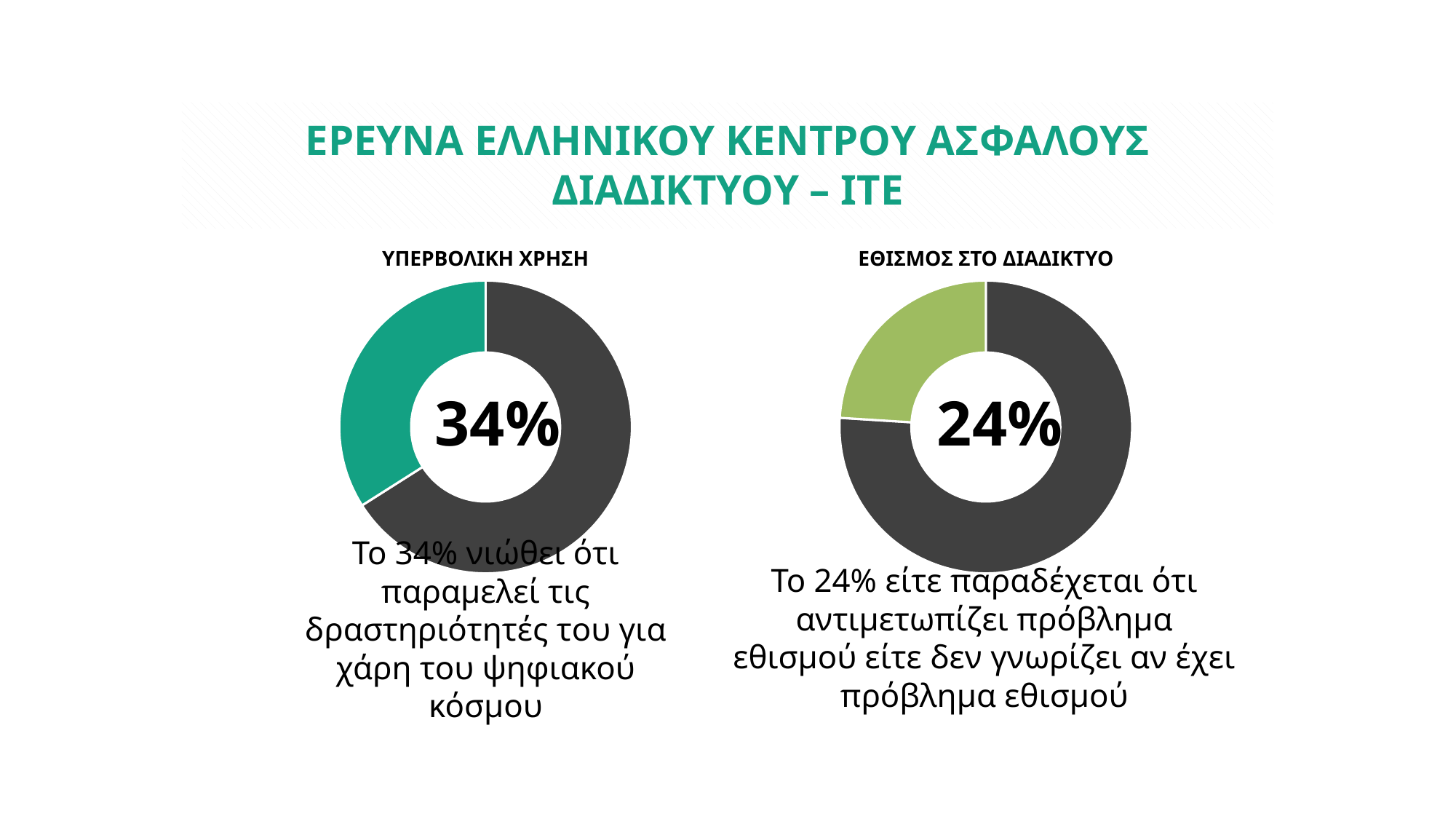
What kind of chart is the "ΕΘΙΣΜΟΣ ΣΤΟ ΔΙΑΔΙΚΤΥΟ" chart? Doughnut (pie) chart Which chart shows the larger highlighted percentage, "ΥΠΕΡΒΟΛΙΚΗ ΧΡΗΣΗ" or "ΕΘΙΣΜΟΣ ΣΤΟ ΔΙΑΔΙΚΤΥΟ"? ΥΠΕΡΒΟΛΙΚΗ ΧΡΗΣΗ In the "ΥΠΕΡΒΟΛΙΚΗ ΧΡΗΣΗ" chart, what share of the ring does the teal (green) slice represent? 34% How many slices does the "ΥΠΕΡΒΟΛΙΚΗ ΧΡΗΣΗ" doughnut chart have? 2 In the "ΥΠΕΡΒΟΛΙΚΗ ΧΡΗΣΗ" chart, what percentage is printed in the centre? 34% In the "ΕΘΙΣΜΟΣ ΣΤΟ ΔΙΑΔΙΚΤΥΟ" chart, what share of the ring does the light green slice represent? 24% What is the title of the chart on the left of the slide? ΥΠΕΡΒΟΛΙΚΗ ΧΡΗΣΗ What is the title of the chart on the right of the slide? ΕΘΙΣΜΟΣ ΣΤΟ ΔΙΑΔΙΚΤΥΟ In the "ΕΘΙΣΜΟΣ ΣΤΟ ΔΙΑΔΙΚΤΥΟ" chart, what percentage is printed in the centre? 24% How many slices does the "ΕΘΙΣΜΟΣ ΣΤΟ ΔΙΑΔΙΚΤΥΟ" doughnut chart have? 2 What kind of chart is the "ΥΠΕΡΒΟΛΙΚΗ ΧΡΗΣΗ" chart? Doughnut (pie) chart What is the difference between the percentage shown in the "ΥΠΕΡΒΟΛΙΚΗ ΧΡΗΣΗ" chart and the percentage shown in the "ΕΘΙΣΜΟΣ ΣΤΟ ΔΙΑΔΙΚΤΥΟ" chart? 10 percentage points